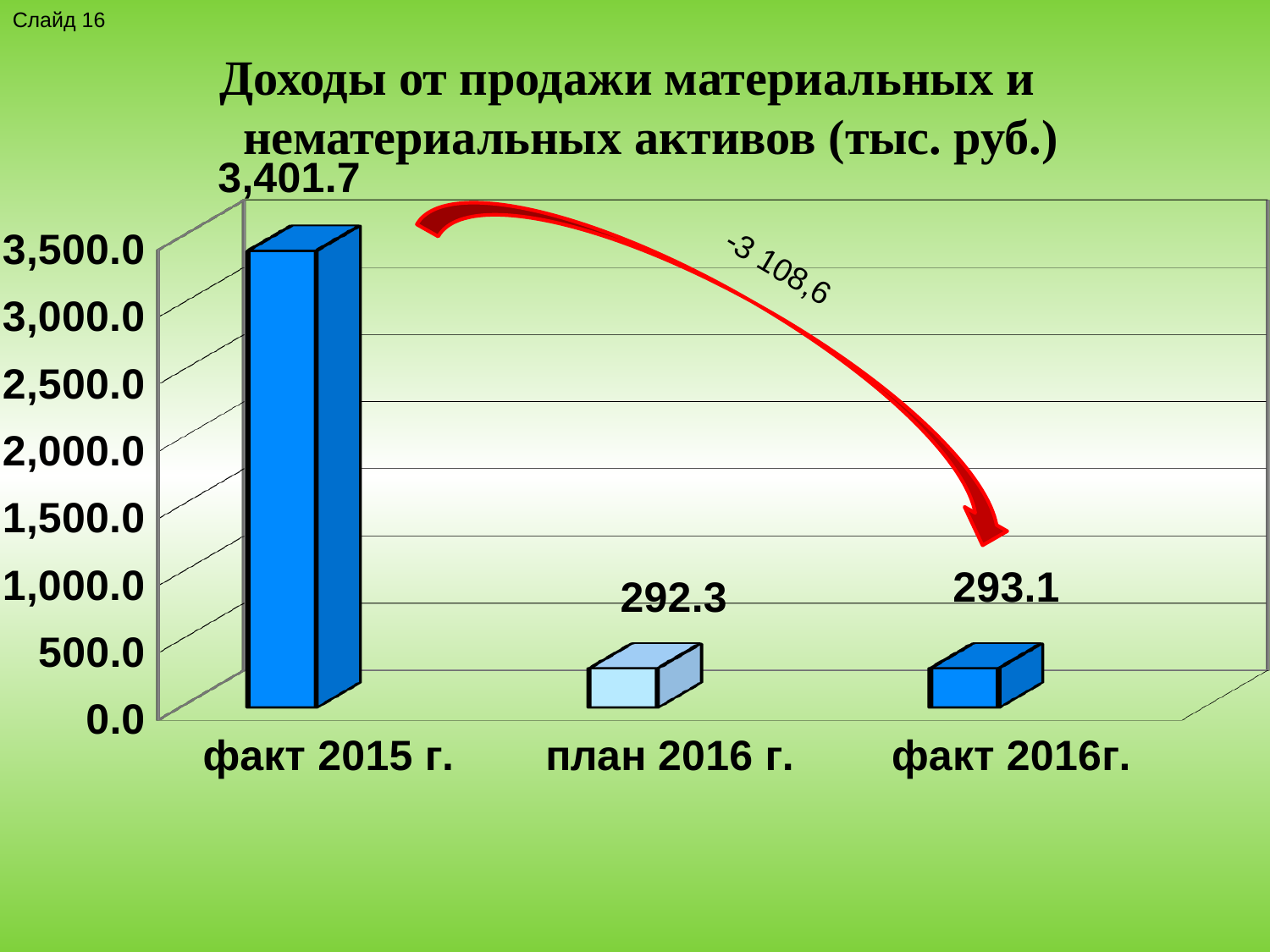
What is the difference between the values for факт 2015 г. and факт 2016г.? 3,108.6 What is the value for факт 2015 г.? 3,401.7 Which category has the highest value? факт 2015 г. Which category has the lowest value? план 2016 г. What is the difference between the values for факт 2016г. and план 2016 г.? 0.8 Which is larger, the value for план 2016 г. or the value for факт 2016г.? факт 2016г. What kind of chart is shown on the slide? bar chart What is the value for факт 2016г.? 293.1 What is the value for план 2016 г.? 292.3 Is the value for факт 2015 г. greater or less than 3,000.0? greater What is the title of the chart? Доходы от продажи материальных и нематериальных активов (тыс. руб.) How many categories are shown on the chart? 3